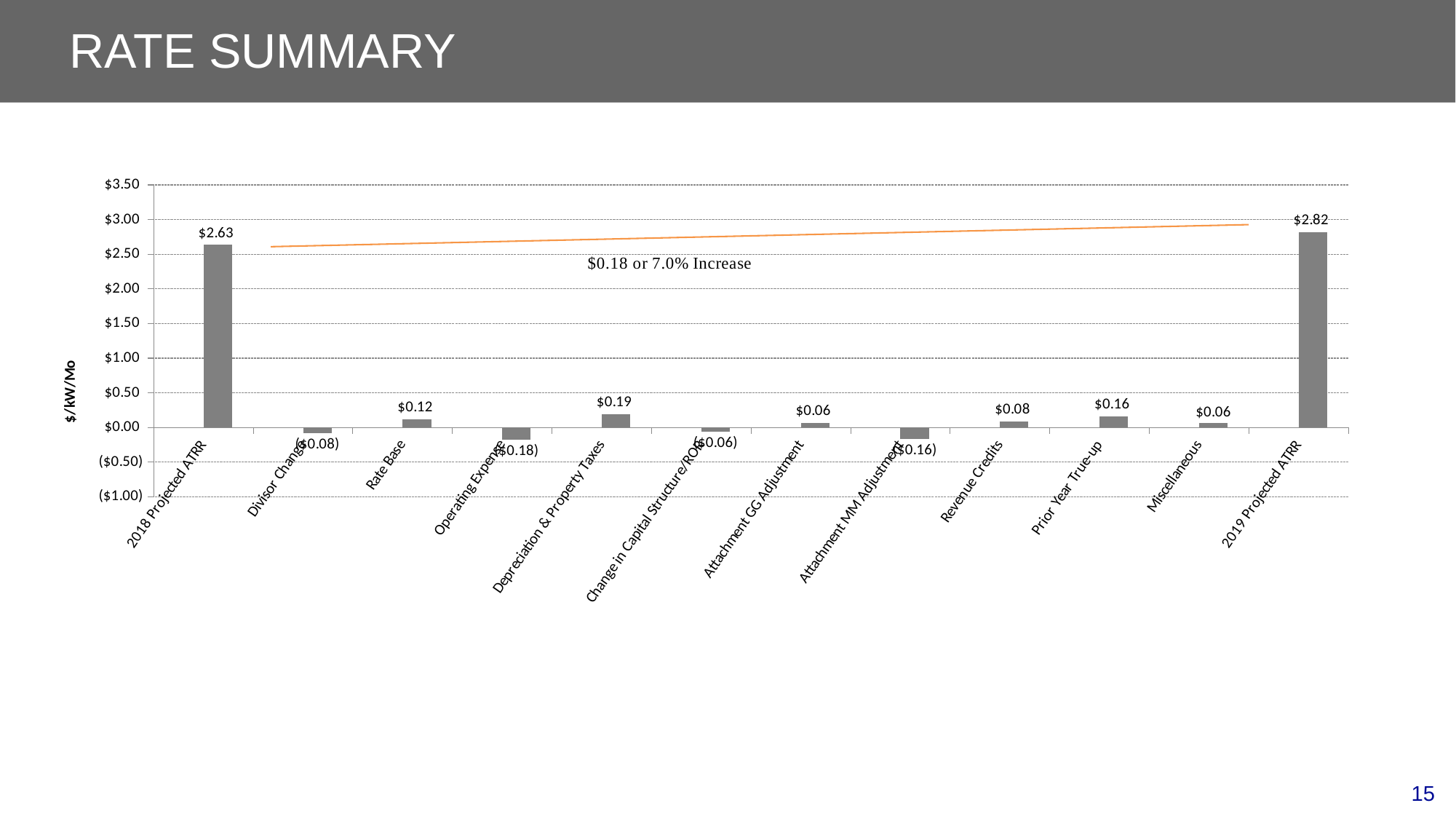
Which category has the highest value? 2019 Projected ATRR Which is larger, the value for Rate Base or the value for Revenue Credits? Rate Base What is the value for 2018 Projected ATRR? $2.63 What is the label on the vertical axis? $/kW/Mo How many categories are shown on the x axis? 12 What is the value for 2019 Projected ATRR? $2.82 What is the value for Prior Year True-up? $0.16 Which category has the lowest value? Operating Expense What kind of chart is shown on the slide? Bar chart What is the value for Depreciation & Property Taxes? $0.19 What is the value for Operating Expense? ($0.18) What is the difference between the 2019 Projected ATRR and the 2018 Projected ATRR? $0.18